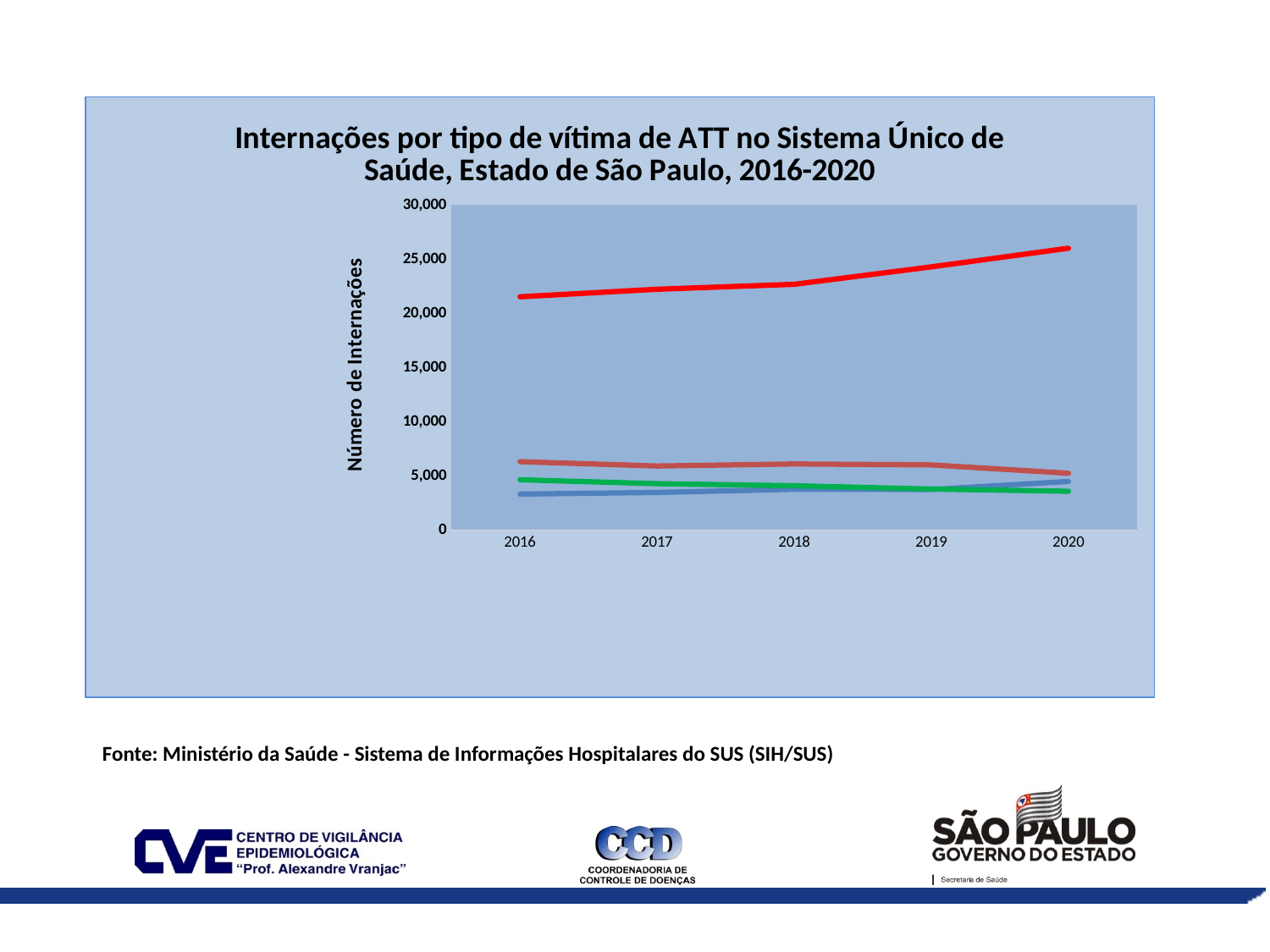
In 2020, which is larger: the value of the red line or the value of the brown line? the red line Is the value of the blue line in 2016 greater or less than 5,000? less Which line has the highest values across all years? the red line Is the value of the red line in 2016 greater or less than 20,000? greater How many lines are plotted on the chart? 4 Does the red line rise or fall from 2016 to 2020? rise What is the label of the vertical axis? Número de Internações Is the value of the red line in 2018 greater or less than 25,000? less What kind of chart is shown on the slide? line chart What is the title of the chart? Internações por tipo de vítima de ATT no Sistema Único de Saúde, Estado de São Paulo, 2016-2020 How many years are shown along the x axis? 5 Does the blue line rise or fall from 2016 to 2020? rise